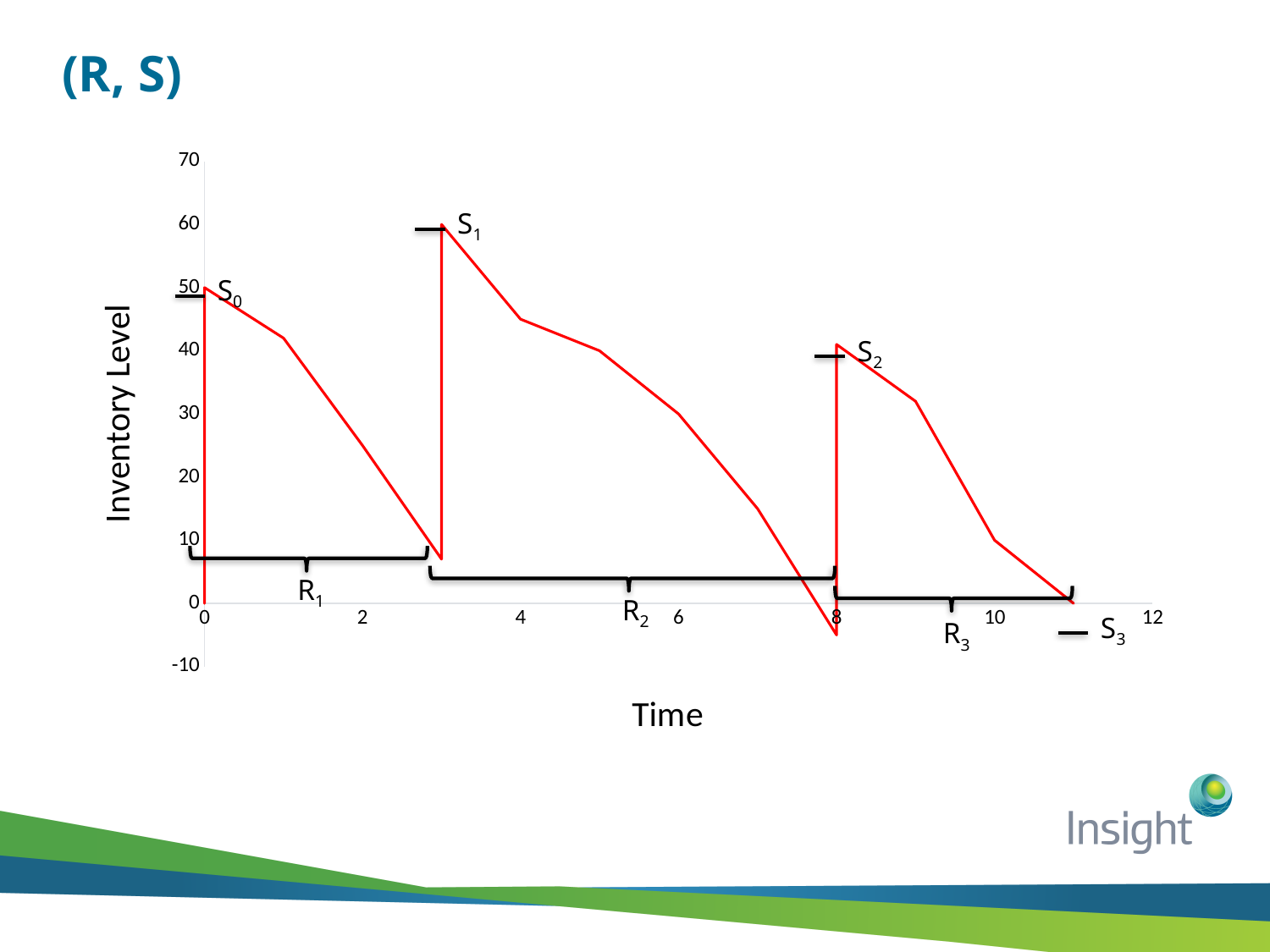
How many review periods labelled R are marked on the chart? 3 What is the label of the vertical axis? Inventory Level Which is higher, the inventory level at S1 or at S2? S1 Of the levels S0, S1 and S2, which is the highest? S1 Is the inventory level at S2 greater or less than 50? less Which is higher, the inventory level at S0 or at S1? S1 Of the levels S0, S1 and S2, which is the lowest? S2 What is the label of the horizontal axis? Time Is the inventory level at S1 greater or less than 50? greater What kind of chart is shown on the slide? line chart Between replenishments, does the inventory level rise or fall over time? fall Is the inventory level at S0 greater or less than 40? greater